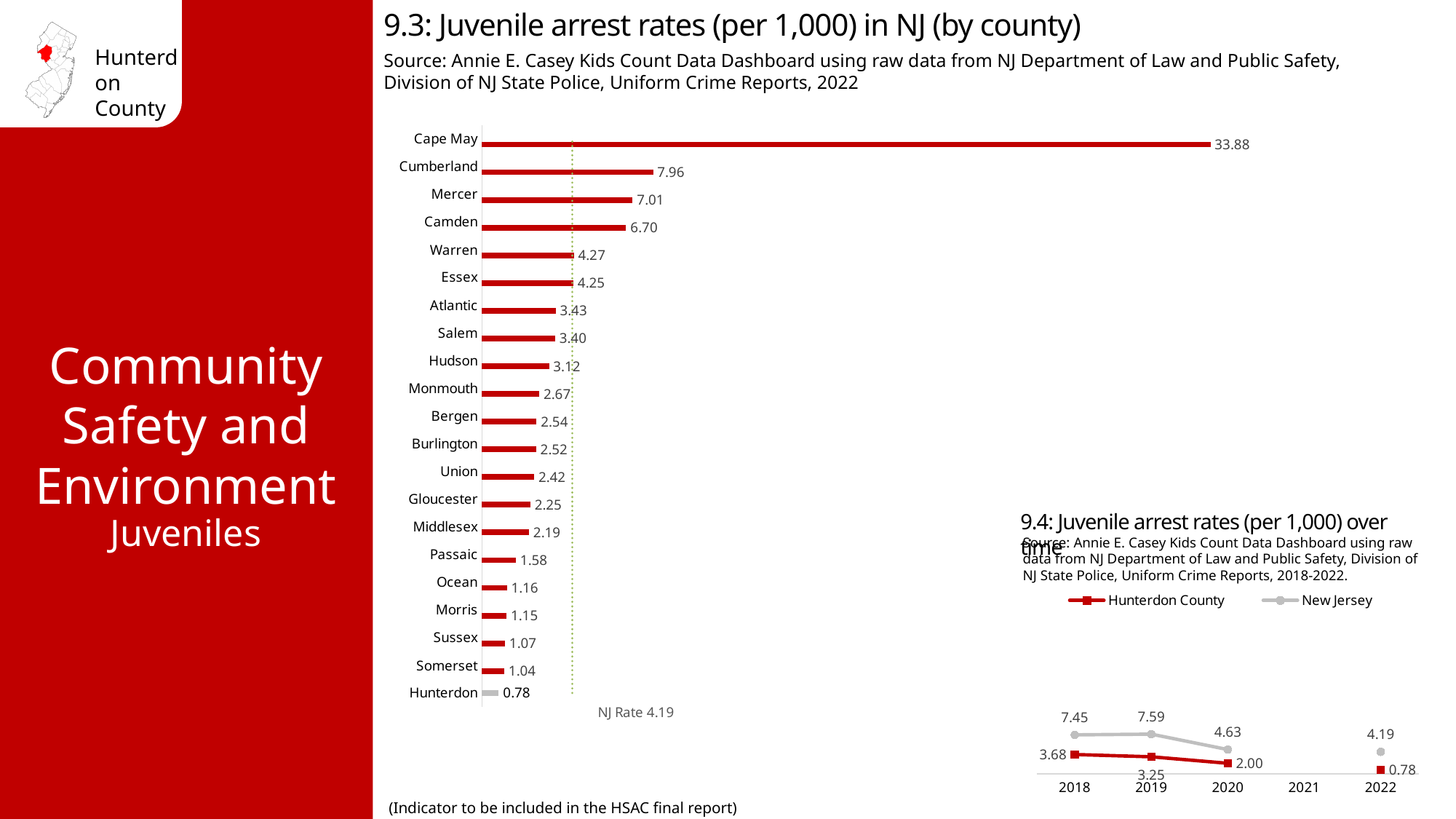
In the chart '9.3: Juvenile arrest rates (per 1,000) in NJ (by county)', what is the difference between Cumberland and Mercer? 0.95 In the chart '9.3: Juvenile arrest rates (per 1,000) in NJ (by county)', what is the value for Hunterdon? 0.78 In the chart '9.3: Juvenile arrest rates (per 1,000) in NJ (by county)', which county has the highest rate? Cape May In the chart '9.4: Juvenile arrest rates (per 1,000) over time', how many series does the legend list? 2 In the chart '9.3: Juvenile arrest rates (per 1,000) in NJ (by county)', what NJ rate is marked by the dotted reference line? 4.19 In the chart '9.3: Juvenile arrest rates (per 1,000) in NJ (by county)', which is larger, Camden or Warren? Camden In the chart '9.4: Juvenile arrest rates (per 1,000) over time', what is the value for Hunterdon County in 2020? 2.00 In the chart '9.3: Juvenile arrest rates (per 1,000) in NJ (by county)', how many counties are shown? 21 In the chart '9.4: Juvenile arrest rates (per 1,000) over time', does the Hunterdon County rate rise or fall from 2018 to 2022? Fall In the chart '9.3: Juvenile arrest rates (per 1,000) in NJ (by county)', which county has the lowest rate? Hunterdon What kind of chart is '9.3: Juvenile arrest rates (per 1,000) in NJ (by county)'? Bar chart In the chart '9.3: Juvenile arrest rates (per 1,000) in NJ (by county)', what is the value for Cape May? 33.88